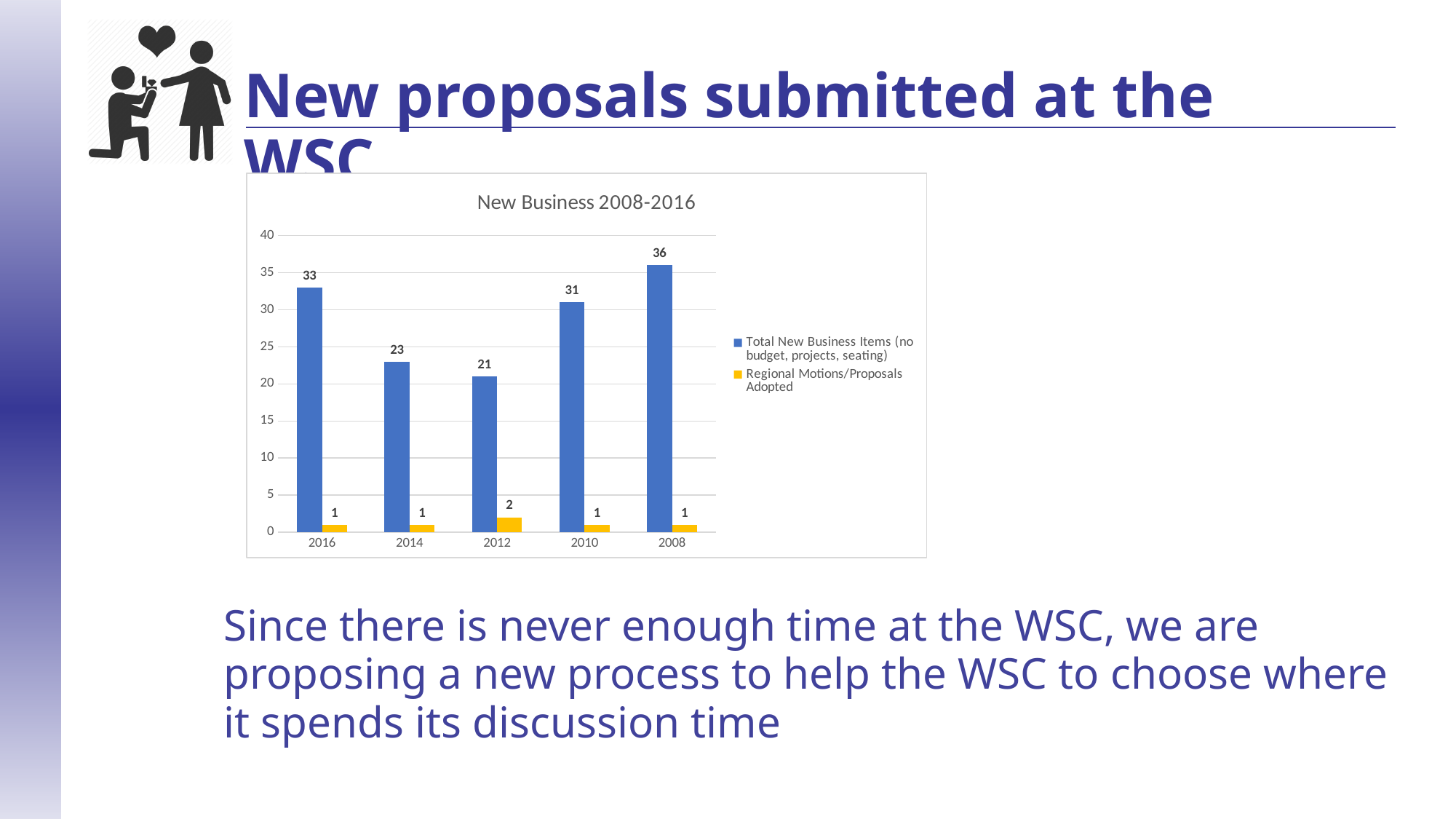
Which is larger, Total New Business Items for 2016 or for 2010? 2016 Which colour represents Regional Motions/Proposals Adopted? Yellow What is the value of Regional Motions/Proposals Adopted for 2012? 2 How many series does the legend list? 2 Which year has the lowest value for Total New Business Items (no budget, projects, seating)? 2012 How many years are shown on the x axis? 5 Which year has the highest value for Total New Business Items (no budget, projects, seating)? 2008 What is the title of the chart? New Business 2008-2016 What is the difference between Total New Business Items for 2008 and 2012? 15 What is the value of Total New Business Items (no budget, projects, seating) for 2008? 36 What is the value of Total New Business Items (no budget, projects, seating) for 2016? 33 What kind of chart is shown? Bar chart